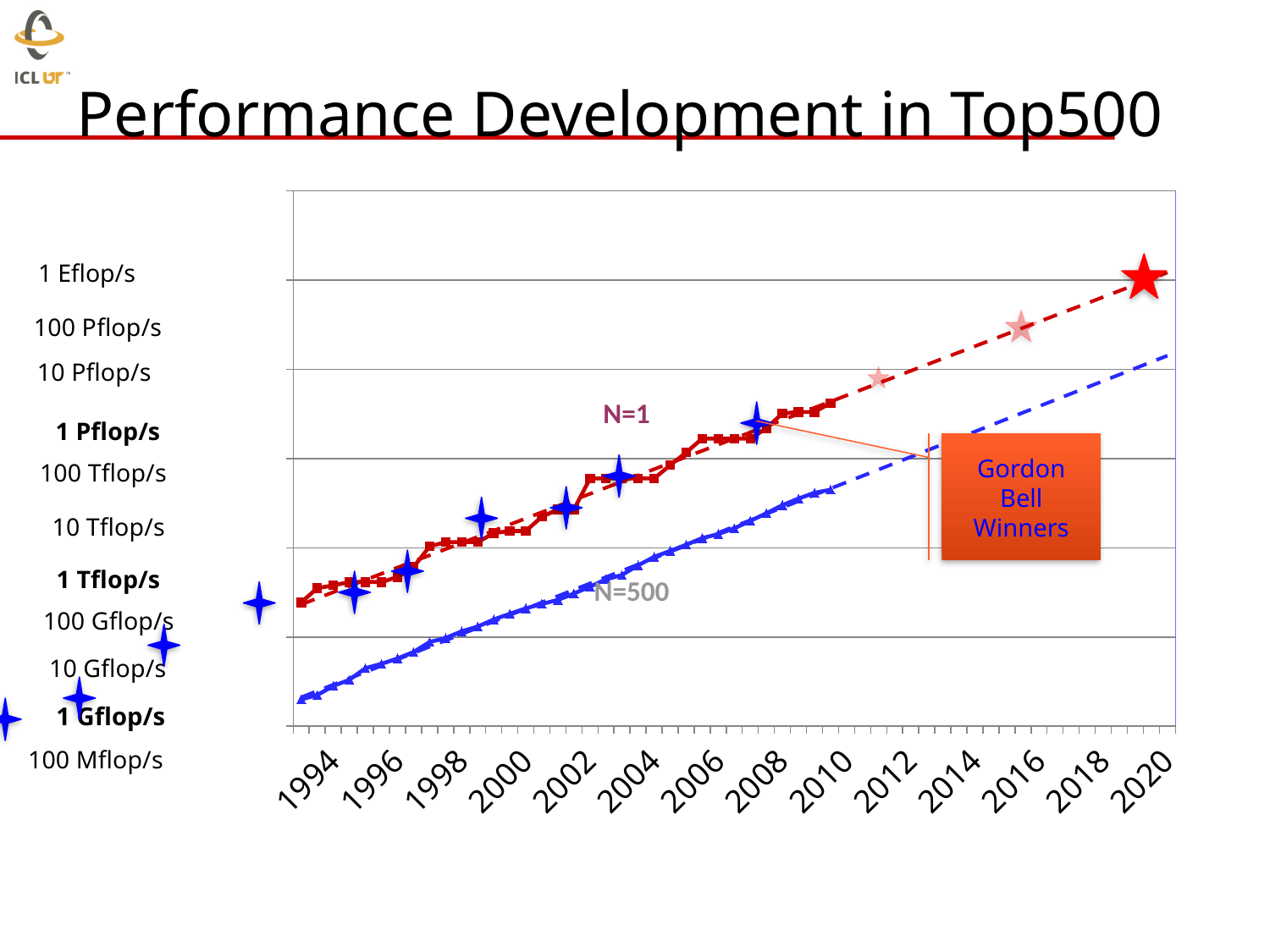
What is the title of the slide's chart? Performance Development in Top500 How many data series are plotted on the chart? 2 Is the N=500 value in 1994 greater or less than 10 Gflop/s? less Is the N=1 value in 1994 greater or less than 1 Tflop/s? less Does the N=1 series rise or fall from 1994 to 2010? rise Does the N=500 series rise or fall along the x axis? rise What kind of chart is shown on the slide? line chart What is the first year labelled on the x axis? 1994 In 2000, which series has the higher value, N=1 or N=500? N=1 What are the two series labelled on the chart? N=1 and N=500 Is the N=1 value in 2008 greater or less than 100 Tflop/s? greater